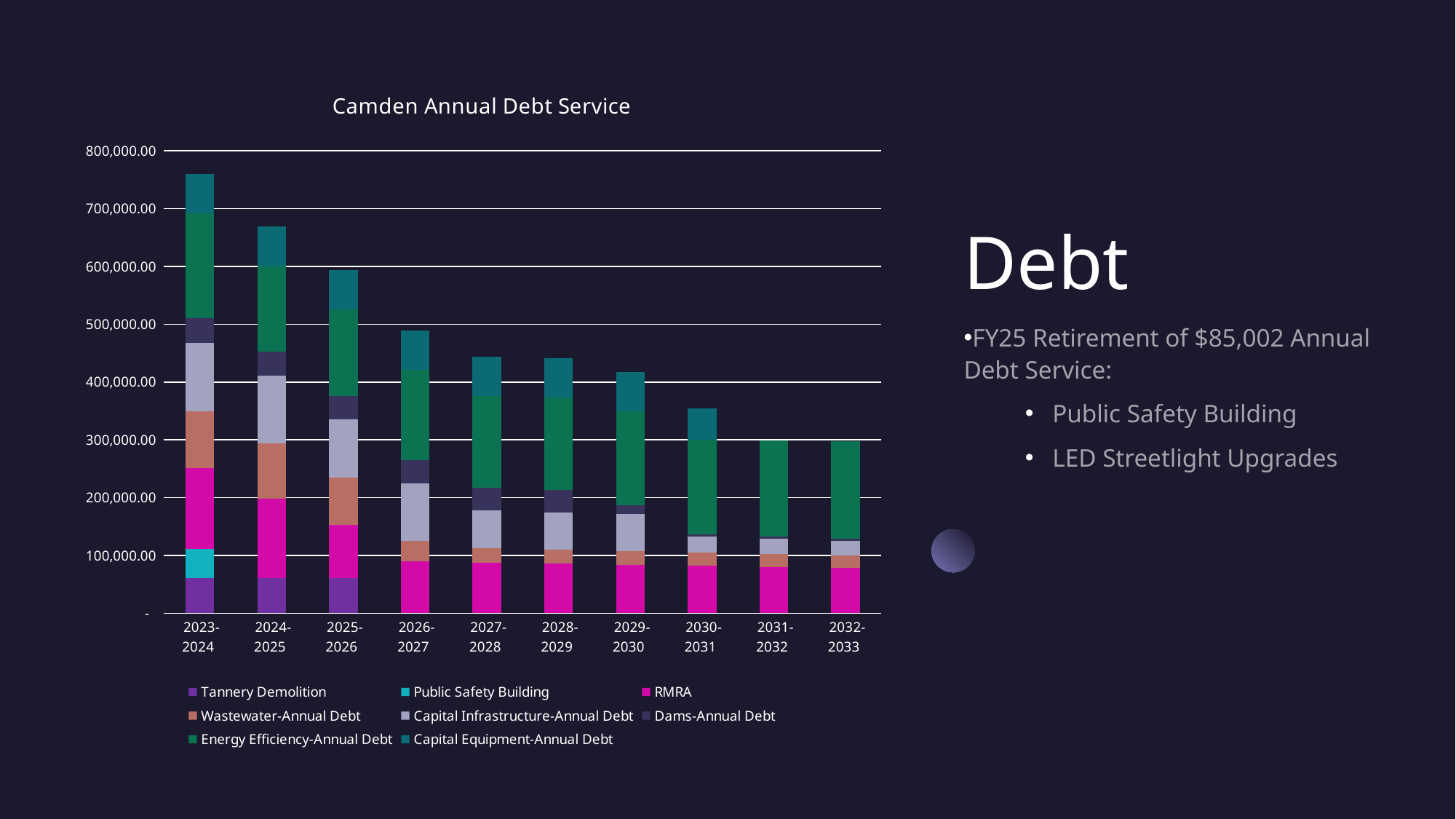
What kind of chart is shown on the slide? Stacked bar chart Is the total annual debt service for 2027-2028 greater or less than 500,000.00? less Is the total annual debt service for 2030-2031 greater or less than 300,000.00? greater Which fiscal year has the larger total annual debt service, 2029-2030 or 2030-2031? 2029-2030 How many fiscal years are shown along the x axis of the chart? 10 Which fiscal year has the highest total annual debt service? 2023-2024 Which fiscal year has the larger total annual debt service, 2023-2024 or 2024-2025? 2023-2024 Do the total annual debt service values generally rise or fall from 2023-2024 to 2032-2033? Fall How many series does the chart's legend list? 8 Which series in the legend appears only in the 2023-2024 bar? Public Safety Building What is the title of the chart? Camden Annual Debt Service Is the total annual debt service for 2023-2024 greater or less than 700,000.00? greater